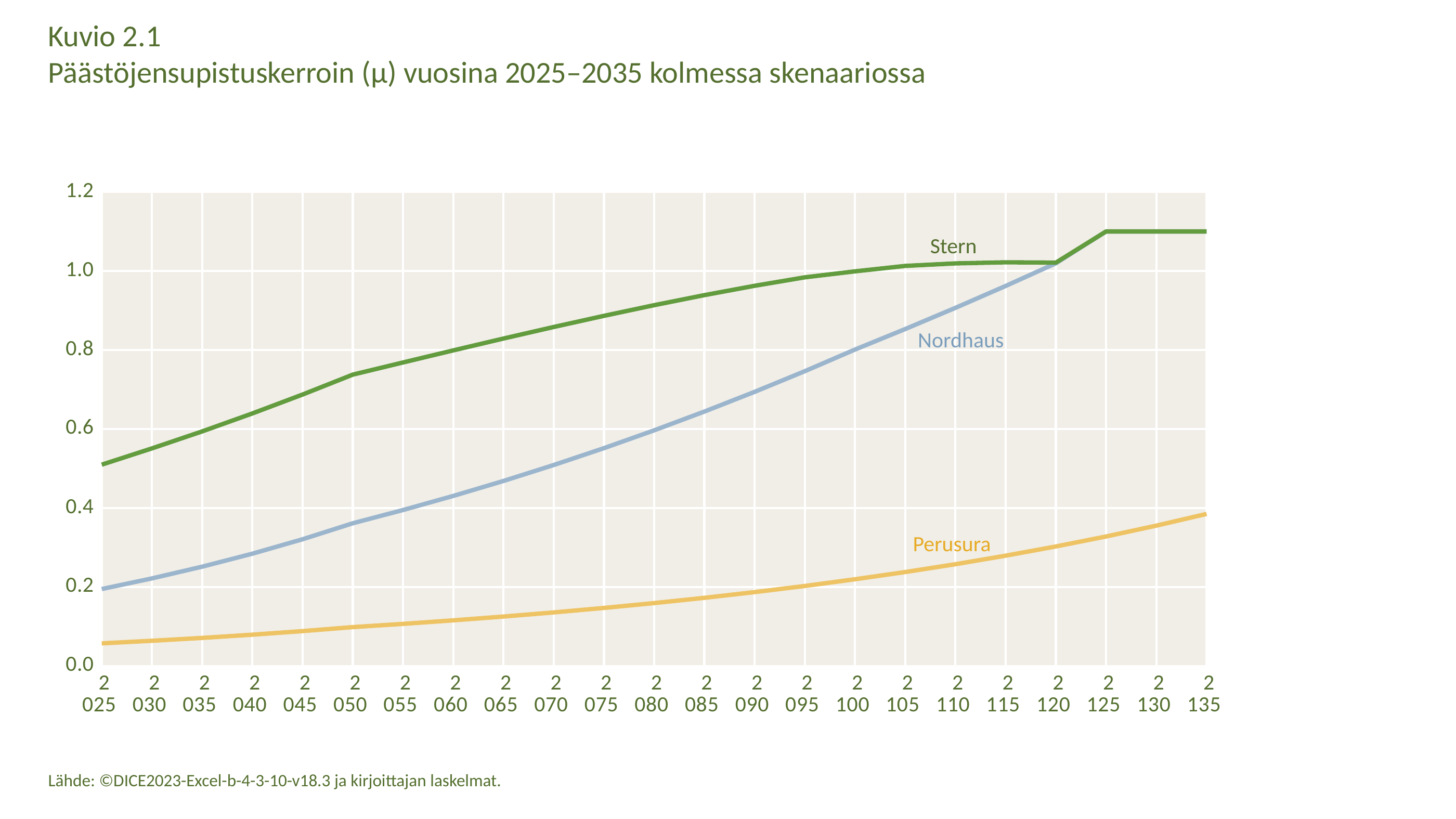
Is the value for Stern in 2135 greater or less than 1.0? greater How many series (scenarios) are plotted on the chart? 3 Is the value for Stern in 2025 greater or less than 0.4? greater Which scenario has the lowest value in 2135? Perusura Which is larger in 2050, the value for Stern or the value for Nordhaus? Stern What kind of chart is shown on the slide? line chart Does the Perusura line rise or fall from 2025 to 2135? rise Is the value for Nordhaus in 2075 greater or less than 0.4? greater Which scenario has the highest value in 2025? Stern What is the title of the chart? Päästöjensupistuskerroin (μ) vuosina 2025–2035 kolmessa skenaariossa How many years are marked on the x axis of the chart? 23